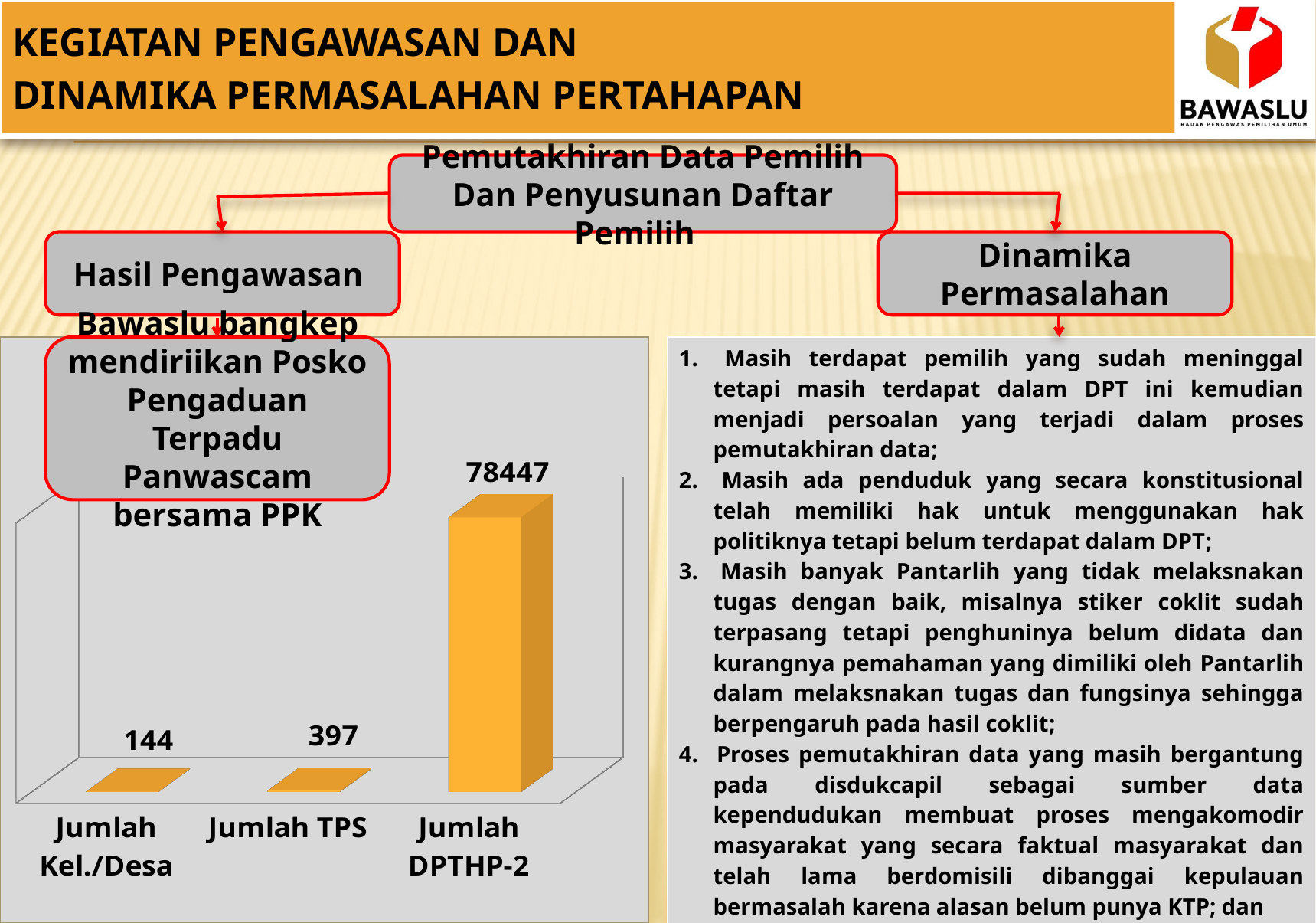
What is the value for Jumlah Kel./Desa? 144 What is the value for Jumlah TPS? 397 Do the values rise or fall from left to right across the categories? rise Which category has the highest value? Jumlah DPTHP-2 Which is larger, the value for Jumlah TPS or the value for Jumlah Kel./Desa? Jumlah TPS What colour are the bars in the chart? orange How many categories are shown in the chart? 3 What kind of chart is shown on the slide? bar chart What is the difference between the values for Jumlah TPS and Jumlah Kel./Desa? 253 Which category has the lowest value? Jumlah Kel./Desa What is the difference between the values for Jumlah DPTHP-2 and Jumlah TPS? 78050 What is the value for Jumlah DPTHP-2? 78447